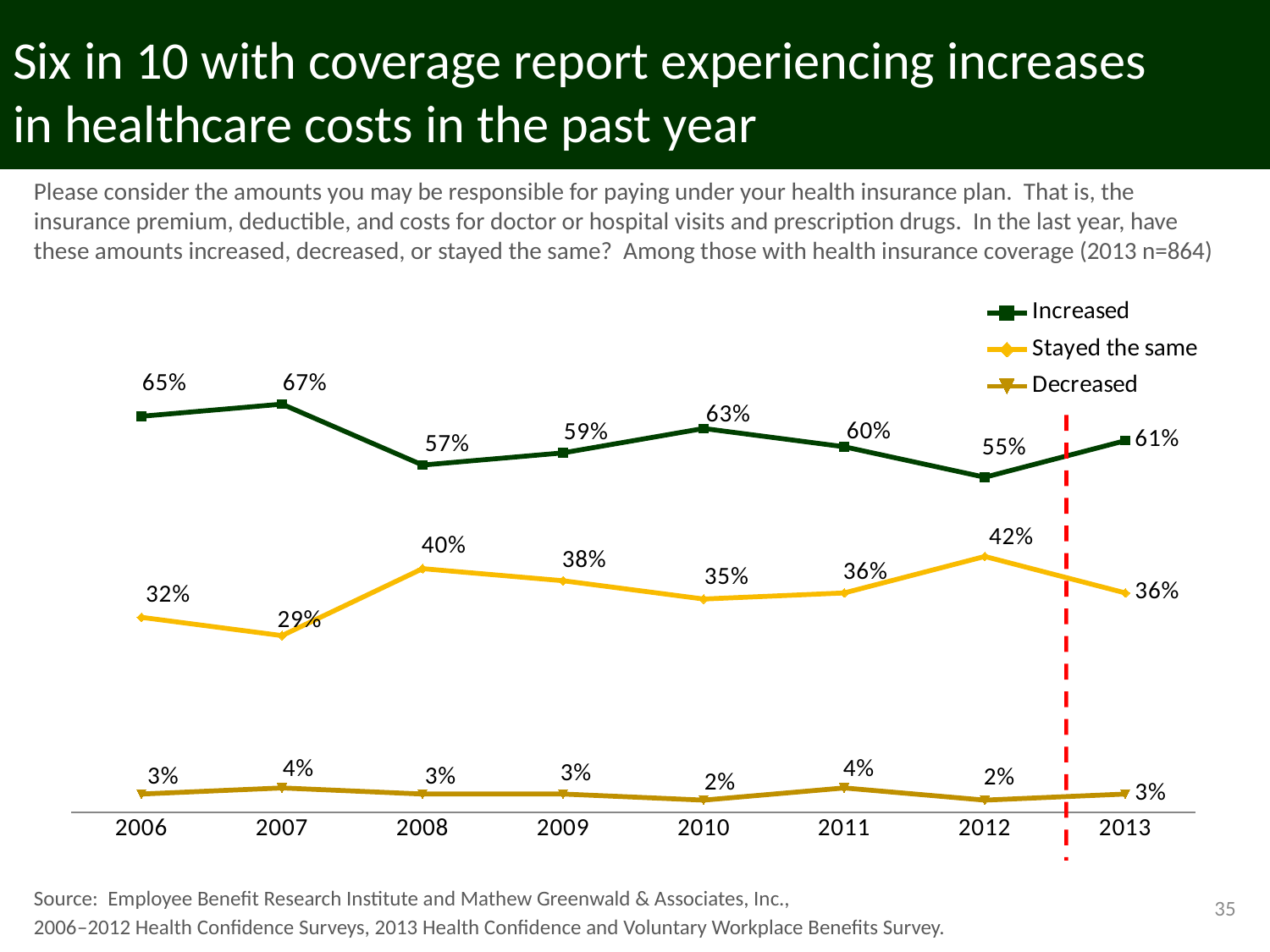
Did the Increased series rise or fall from 2012 to 2013? Rise What is the difference between the Increased value in 2007 and the Increased value in 2012? 12 percentage points How many series does the legend list? 3 How many years are shown on the x axis? 8 In which year was the Increased series at its highest? 2007 What percentage reported their costs Decreased in 2011? 4% What percentage reported their healthcare costs Increased in 2013? 61% Which is larger: the Stayed the same value in 2009 or the Stayed the same value in 2010? 2009 In which year was the Stayed the same series at its highest? 2012 What kind of chart is shown on the slide? Line chart In which year was the Increased series at its lowest? 2012 What percentage said their costs Stayed the same in 2008? 40%